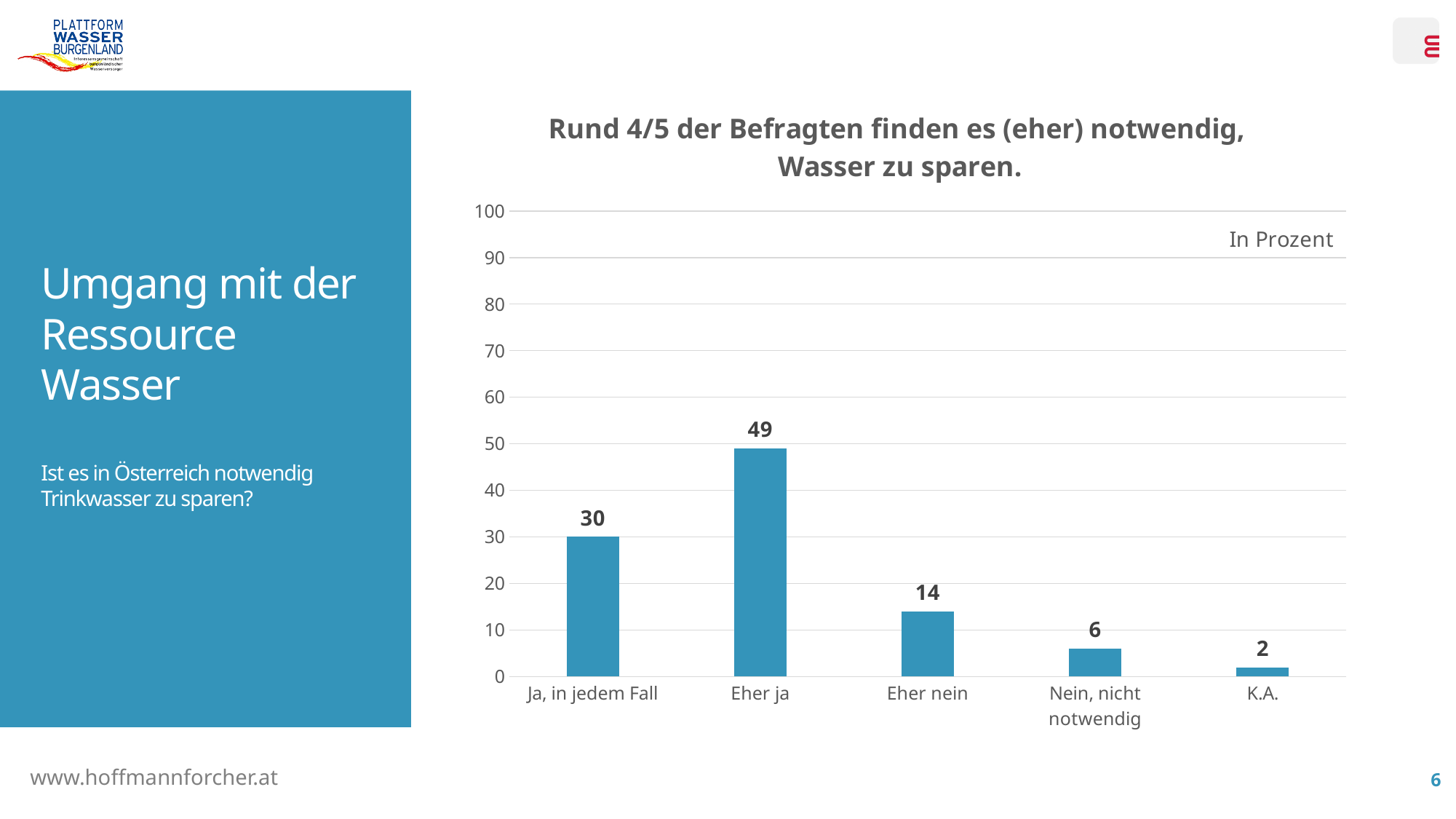
How many categories are shown on the x axis? 5 What unit is indicated for the values in the chart? In Prozent What is the difference between the values for "Eher ja" and "Ja, in jedem Fall"? 19 Which is larger, the value for "Eher nein" or the value for "Nein, nicht notwendig"? Eher nein What is the difference between the values for "Eher nein" and "K.A."? 12 What is the value for "Nein, nicht notwendig"? 6 What is the value for "Eher ja"? 49 Which category has the highest value? Eher ja What kind of chart is shown on the slide? bar chart Which category has the lowest value? K.A. What is the value for "Ja, in jedem Fall"? 30 Is the value for "Eher ja" greater or less than 40? greater